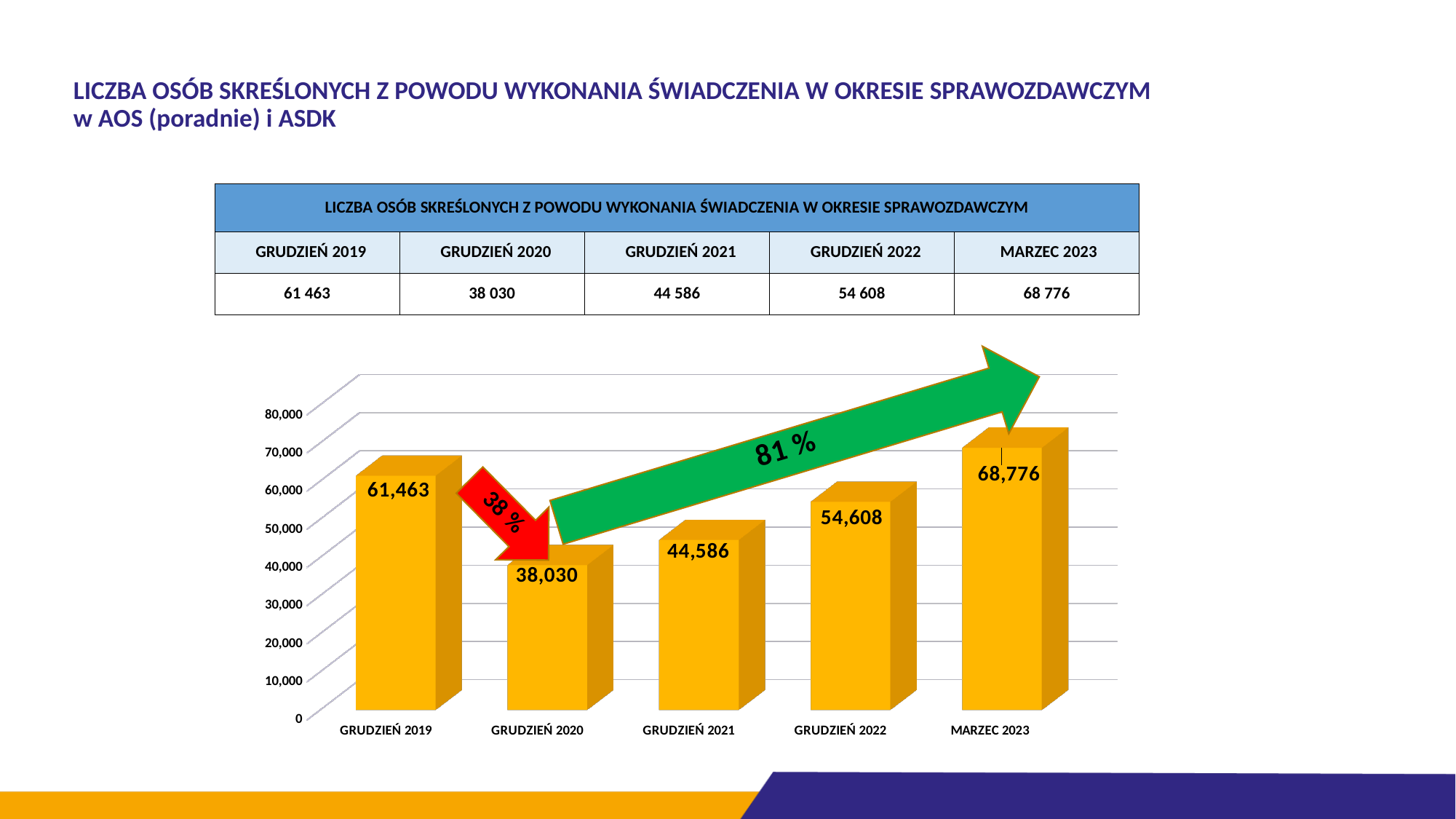
Which category has the highest value? MARZEC 2023 Which category has the lowest value? GRUDZIEŃ 2020 What is the difference between the values for MARZEC 2023 and GRUDZIEŃ 2020? 30,746 What kind of chart is shown on the slide? bar chart What is the value for GRUDZIEŃ 2019? 61,463 How many categories are shown on the x axis? 5 Which is larger, the value for GRUDZIEŃ 2019 or the value for GRUDZIEŃ 2022? GRUDZIEŃ 2019 Is the value for GRUDZIEŃ 2022 greater or less than 50,000? greater What is the value for MARZEC 2023? 68,776 What is the value for GRUDZIEŃ 2021? 44,586 What is the difference between the values for GRUDZIEŃ 2022 and GRUDZIEŃ 2021? 10,022 Do the values rise or fall from GRUDZIEŃ 2020 to MARZEC 2023? rise